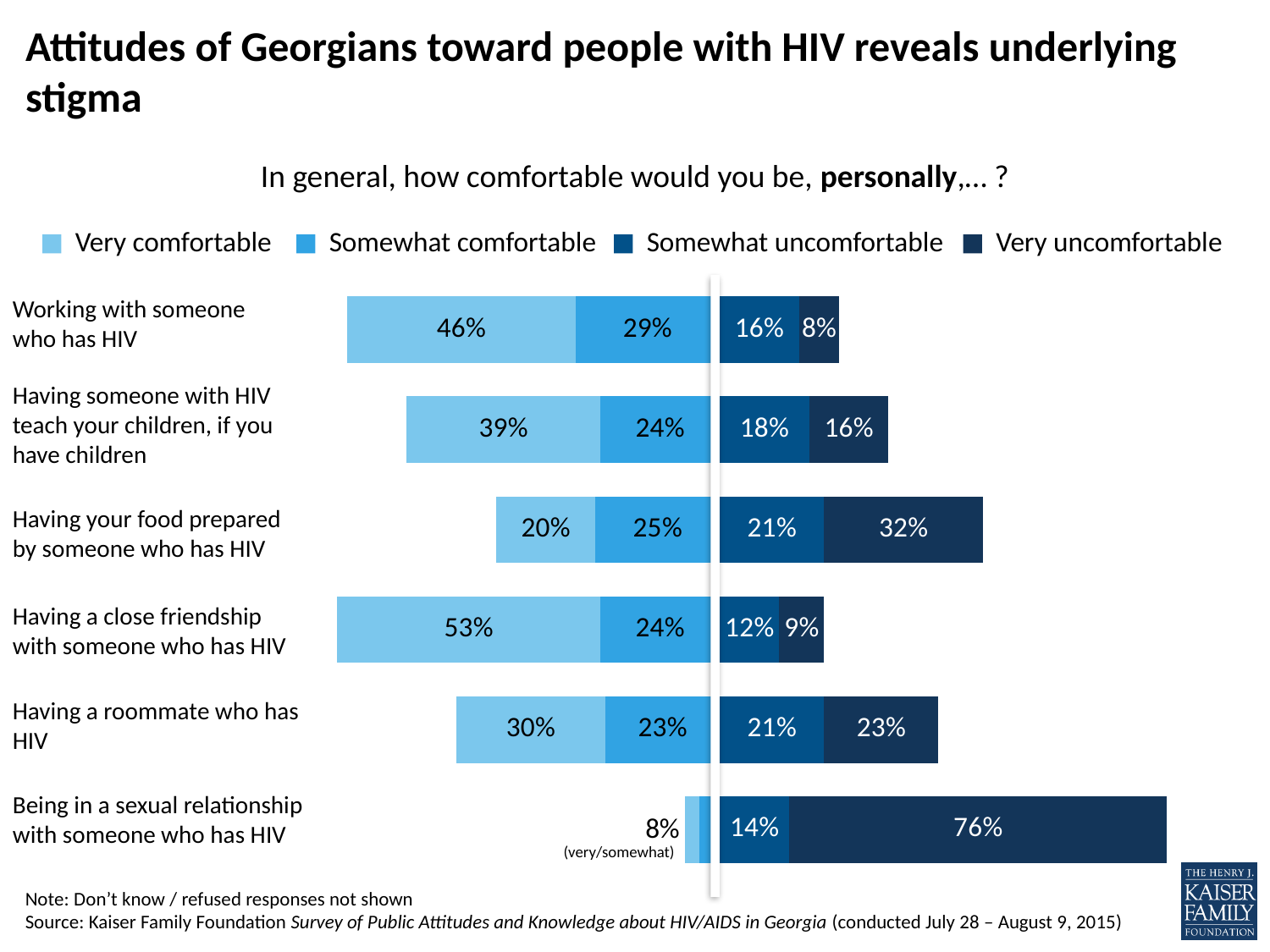
How many scenarios (bars) are shown in the chart? 6 What percentage said they would be somewhat uncomfortable having their food prepared by someone who has HIV? 21% Which response category is shown in the lightest blue in the legend? Very comfortable Which scenario has the highest share of 'Very comfortable' responses? Having a close friendship with someone who has HIV How many percentage points higher is the 'Very comfortable' share for working with someone who has HIV than for having a roommate who has HIV? 16 percentage points Which has a larger 'Very uncomfortable' share: having your food prepared by someone who has HIV, or having a roommate who has HIV? Having your food prepared by someone who has HIV What kind of chart is shown on the slide? Stacked bar chart What percentage of Georgians said they would be very comfortable having a close friendship with someone who has HIV? 53% Which scenario has the lowest share of 'Very uncomfortable' responses? Working with someone who has HIV How many response categories does the legend list? 4 What is the total of the four labelled segments for 'Working with someone who has HIV'? 99% What percentage said they would be very uncomfortable being in a sexual relationship with someone who has HIV? 76%